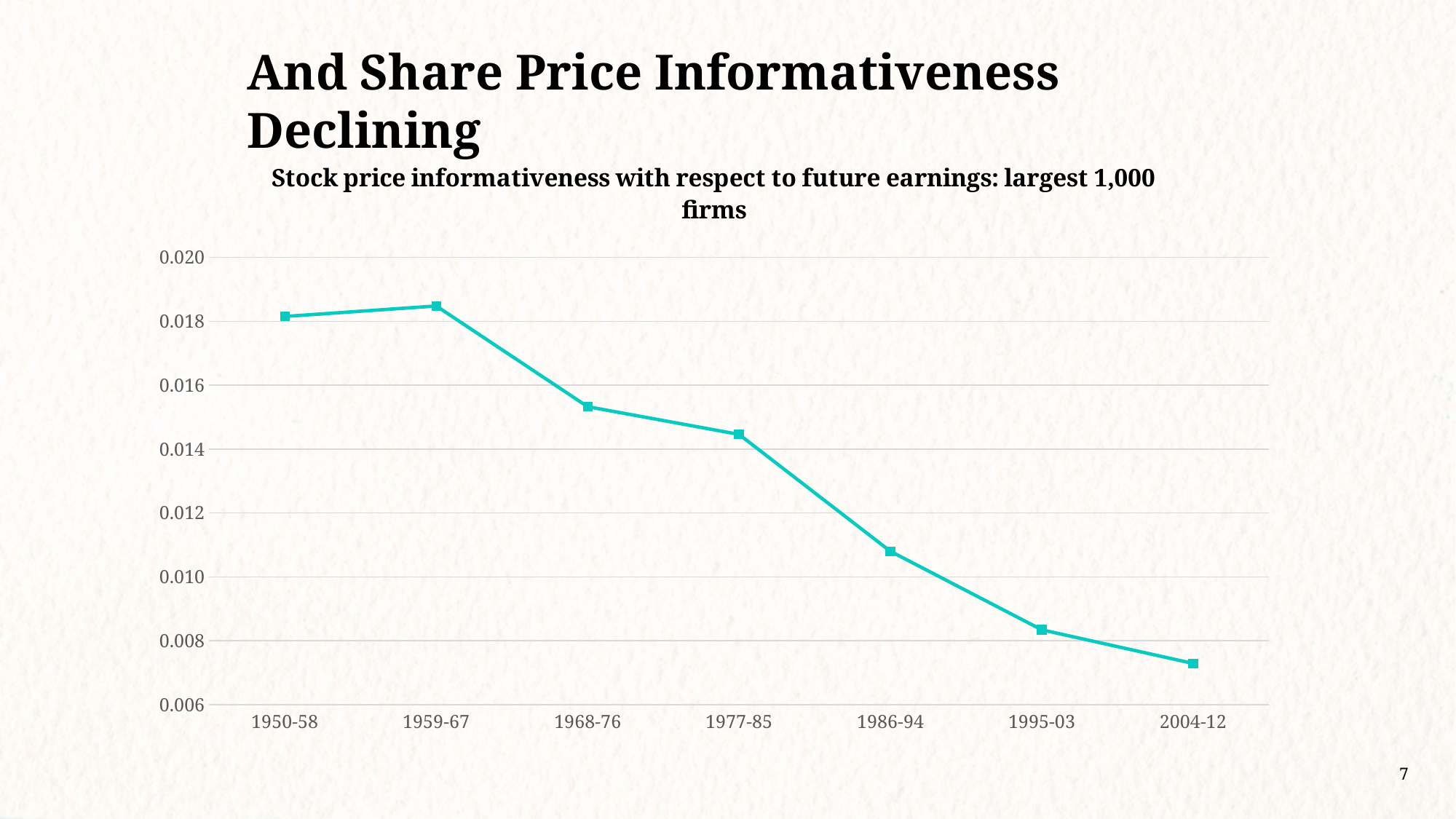
Is the value for 1995-03 greater or less than 0.010? less What kind of chart is shown on the slide? line chart Which period has the lowest stock price informativeness value? 2004-12 Is the value for 1986-94 greater or less than 0.010? greater How many time periods are plotted on the x axis? 7 Is the value for 1968-76 greater or less than 0.016? less Which is larger, the value for 1995-03 or the value for 1977-85? 1977-85 Which is larger, the value for 1968-76 or the value for 1986-94? 1968-76 What is the title of the chart? Stock price informativeness with respect to future earnings: largest 1,000 firms Do the values generally rise or fall from 1959-67 to 2004-12? fall